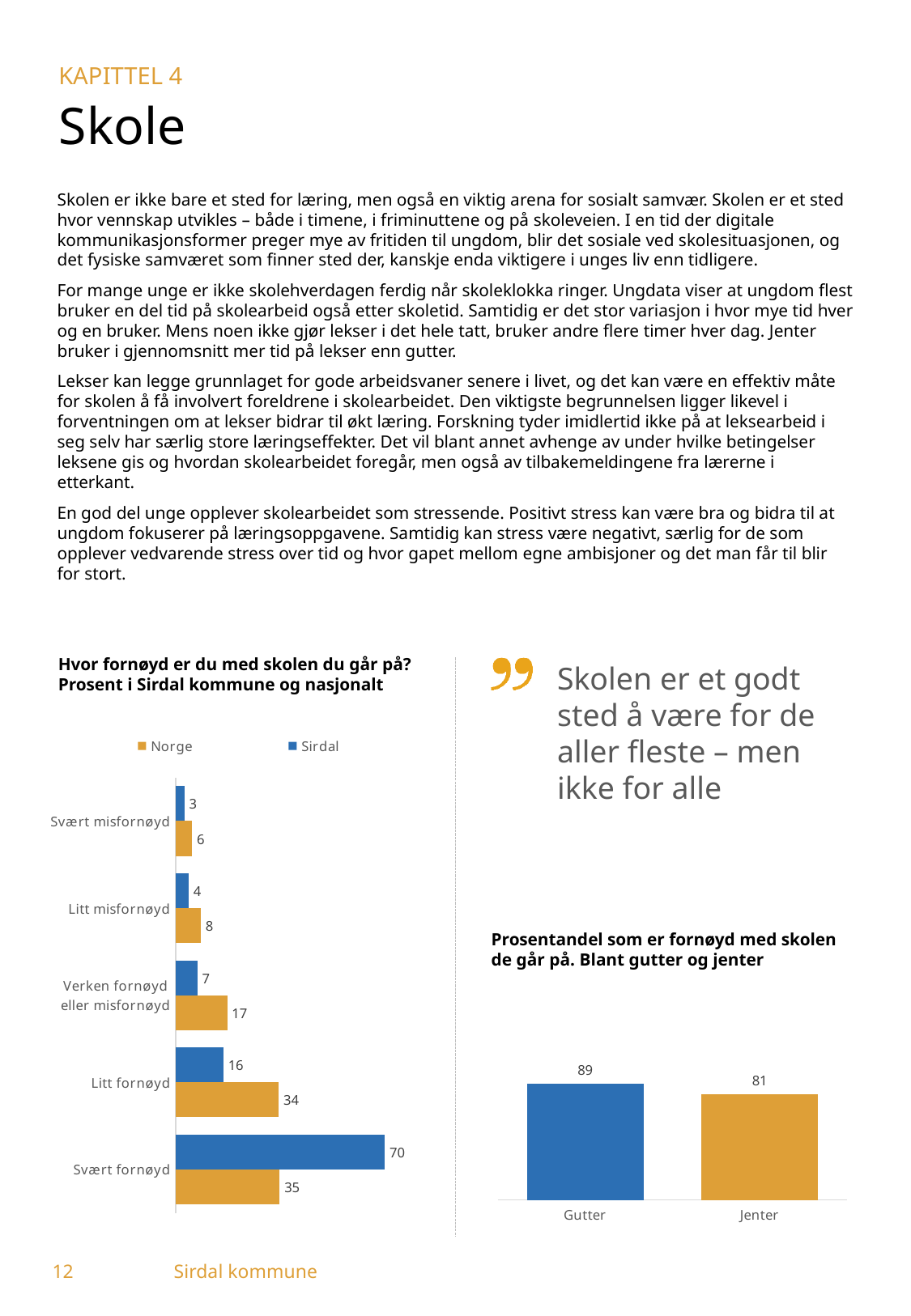
In the chart 'Hvor fornøyd er du med skolen du går på?', what is the difference between the Sirdal and Norge values for 'Svært fornøyd'? 35 How many categories are shown in the chart 'Hvor fornøyd er du med skolen du går på?'? 5 In the chart 'Hvor fornøyd er du med skolen du går på?', which is larger for 'Litt misfornøyd': Norge or Sirdal? Norge In the chart 'Hvor fornøyd er du med skolen du går på?', what is the Norge value for 'Litt fornøyd'? 34 In the chart 'Prosentandel som er fornøyd med skolen de går på', what is the value for Jenter? 81 In the chart 'Prosentandel som er fornøyd med skolen de går på', which group has the higher value? Gutter In the chart 'Hvor fornøyd er du med skolen du går på?', what is the Sirdal value for 'Svært fornøyd'? 70 In the chart 'Hvor fornøyd er du med skolen du går på?', what is the Norge value for 'Verken fornøyd eller misfornøyd'? 17 In the chart 'Prosentandel som er fornøyd med skolen de går på', what is the difference between Gutter and Jenter? 8 In the chart 'Hvor fornøyd er du med skolen du går på?', which category has the lowest Sirdal value? Svært misfornøyd What type of chart is 'Hvor fornøyd er du med skolen du går på?'? Bar chart How many series does the legend list in the chart 'Hvor fornøyd er du med skolen du går på?'? 2